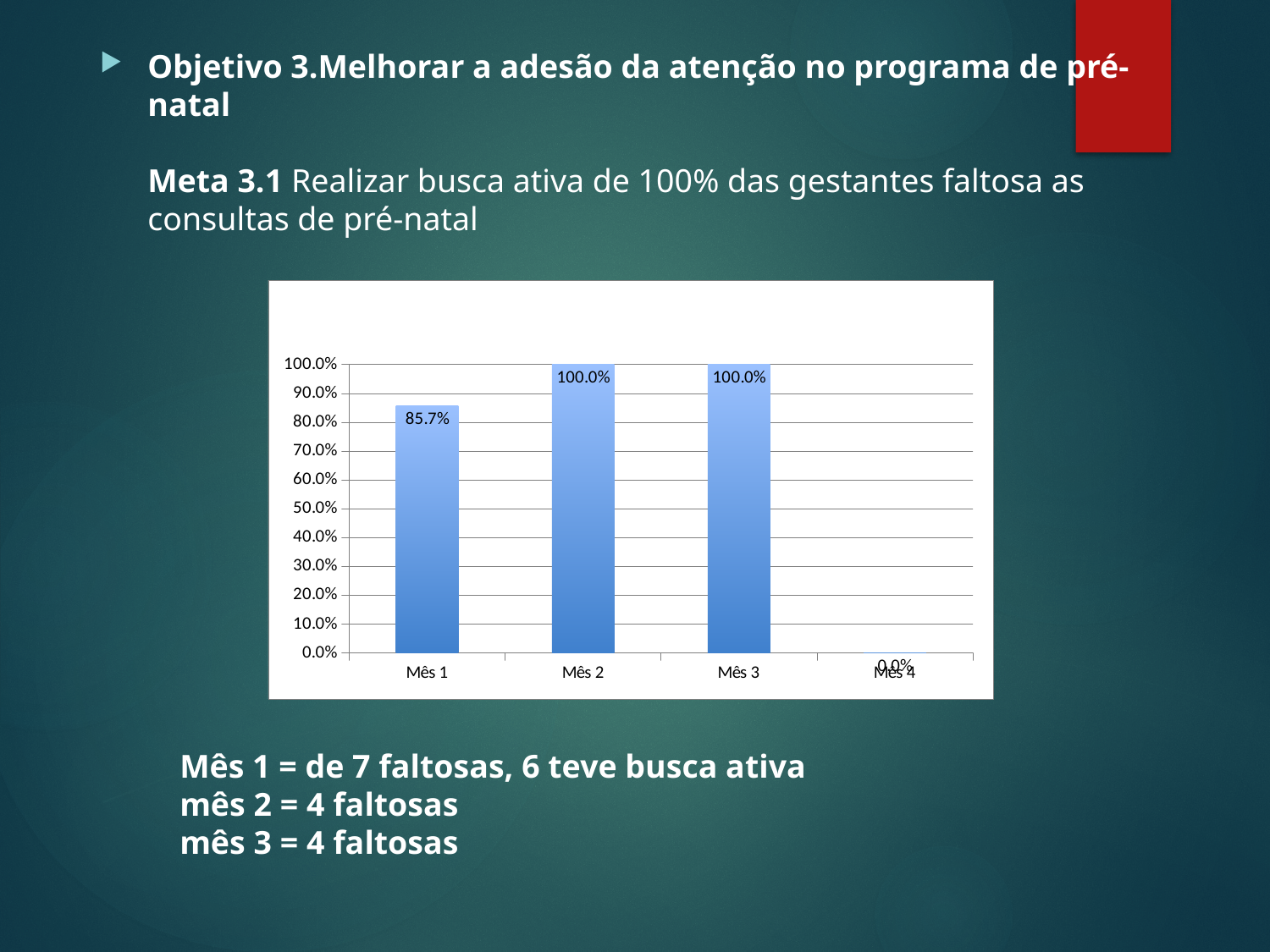
What is the value for Mês 2? 100.0% How many months are shown on the x axis? 4 What is the difference between the values for Mês 2 and Mês 1? 14.3% What kind of chart is shown on the slide? bar chart What is the value for Mês 1? 85.7% Which is larger, the value for Mês 1 or the value for Mês 3? Mês 3 Is the value for Mês 1 greater or less than 80.0%? greater Which month has the lowest value? Mês 4 Does the value rise or fall from Mês 3 to Mês 4? fall What is the value for Mês 4? 0.0% What is the value for Mês 3? 100.0% Does the value rise or fall from Mês 1 to Mês 2? rise